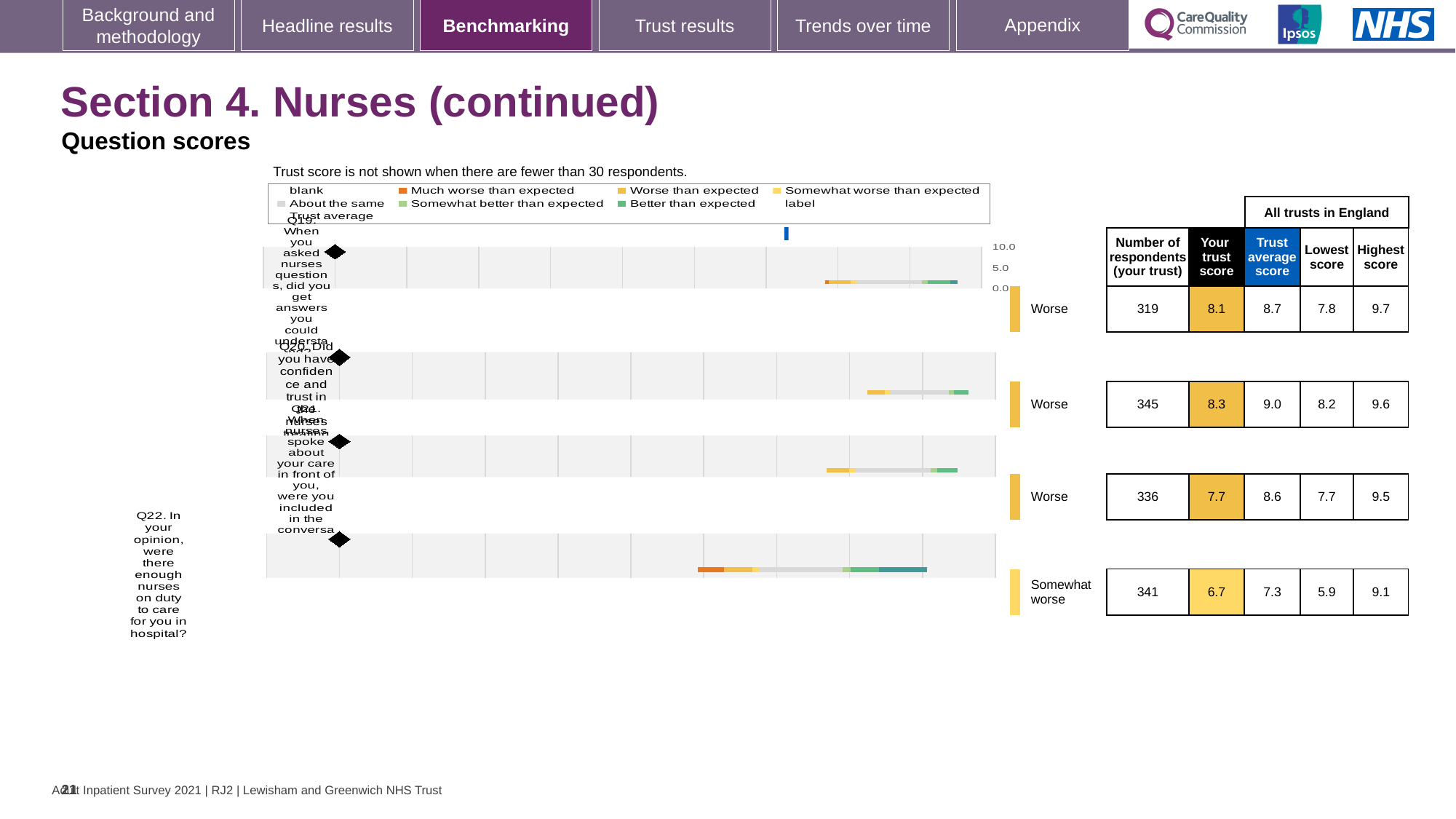
How many questions are plotted on this slide? 4 What is the 'Your trust score' value for Q22 (were there enough nurses on duty)? 6.7 Which is larger: your trust score for Q19 or for Q21? Q19 What is the highest score across all trusts in England for Q21 (were you included in the conversation)? 9.5 Which question has the lowest 'Your trust score' on this slide? Q22 Which question has the highest 'Your trust score' on this slide? Q20 What benchmark category label is shown next to Q22? Somewhat worse What is the lowest score across all trusts in England for Q22? 5.9 What is the difference between the trust average score and your trust score for Q22? 0.6 What kind of chart is used to show the question scores? Bar chart What is the trust average score for Q19 (did you get answers you could understand)? 8.7 How many respondents from your trust answered Q20 (confidence and trust in nurses)? 345